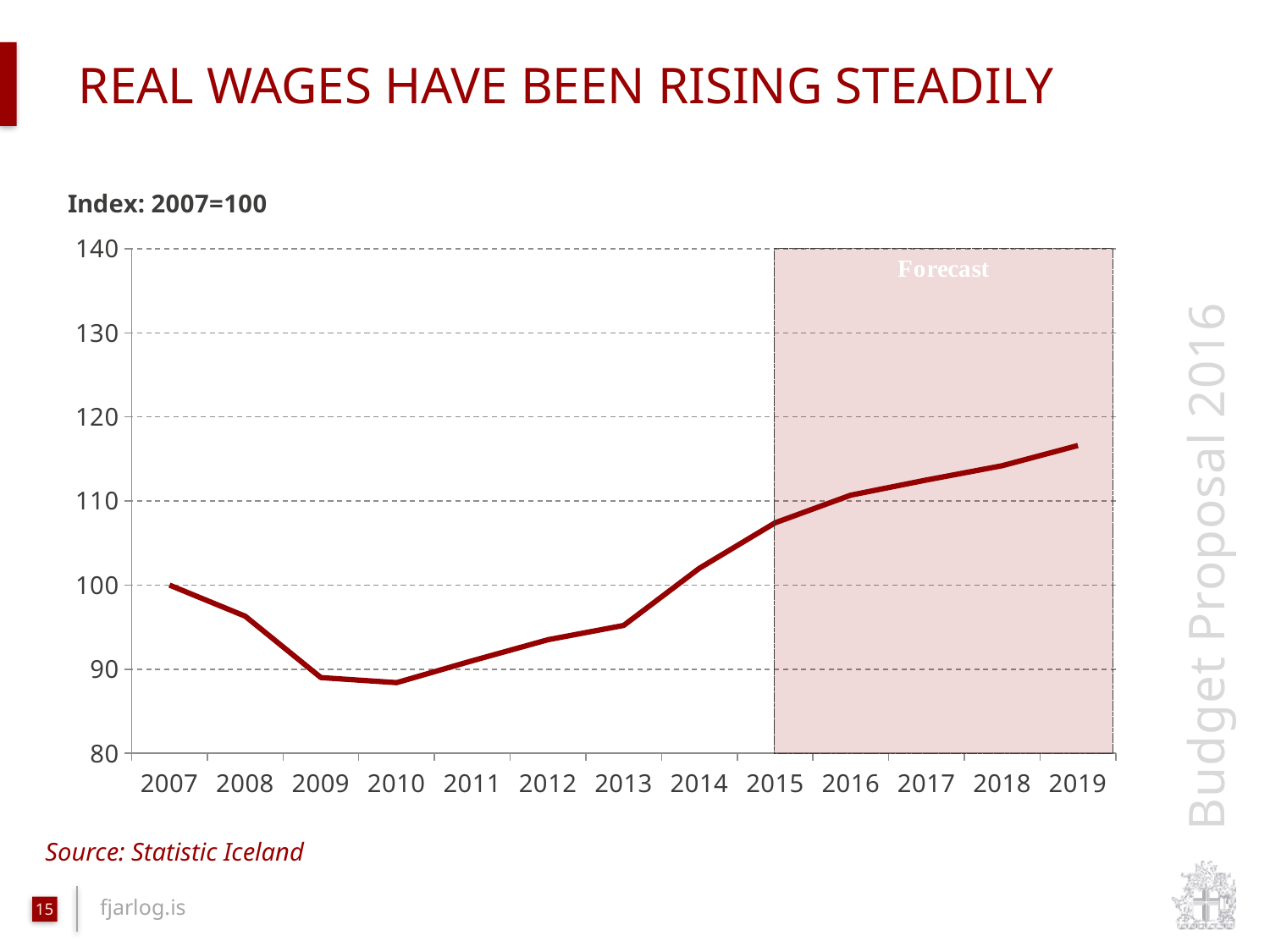
What kind of chart is shown on the slide? line chart How many years are plotted on the x axis? 13 Is the value for 2014 greater or less than 100? greater Is the value for 2009 greater or less than 90? less Do the values rise or fall between 2010 and 2019? rise Is the value for 2019 greater or less than 120? less What is the value of the real wage index for 2007? 100 From which year onward does the shaded 'Forecast' area begin? 2015 Which year has the larger value, 2013 or 2014? 2014 Which year has the highest value on the chart? 2019 Do the values rise or fall between 2007 and 2009? fall